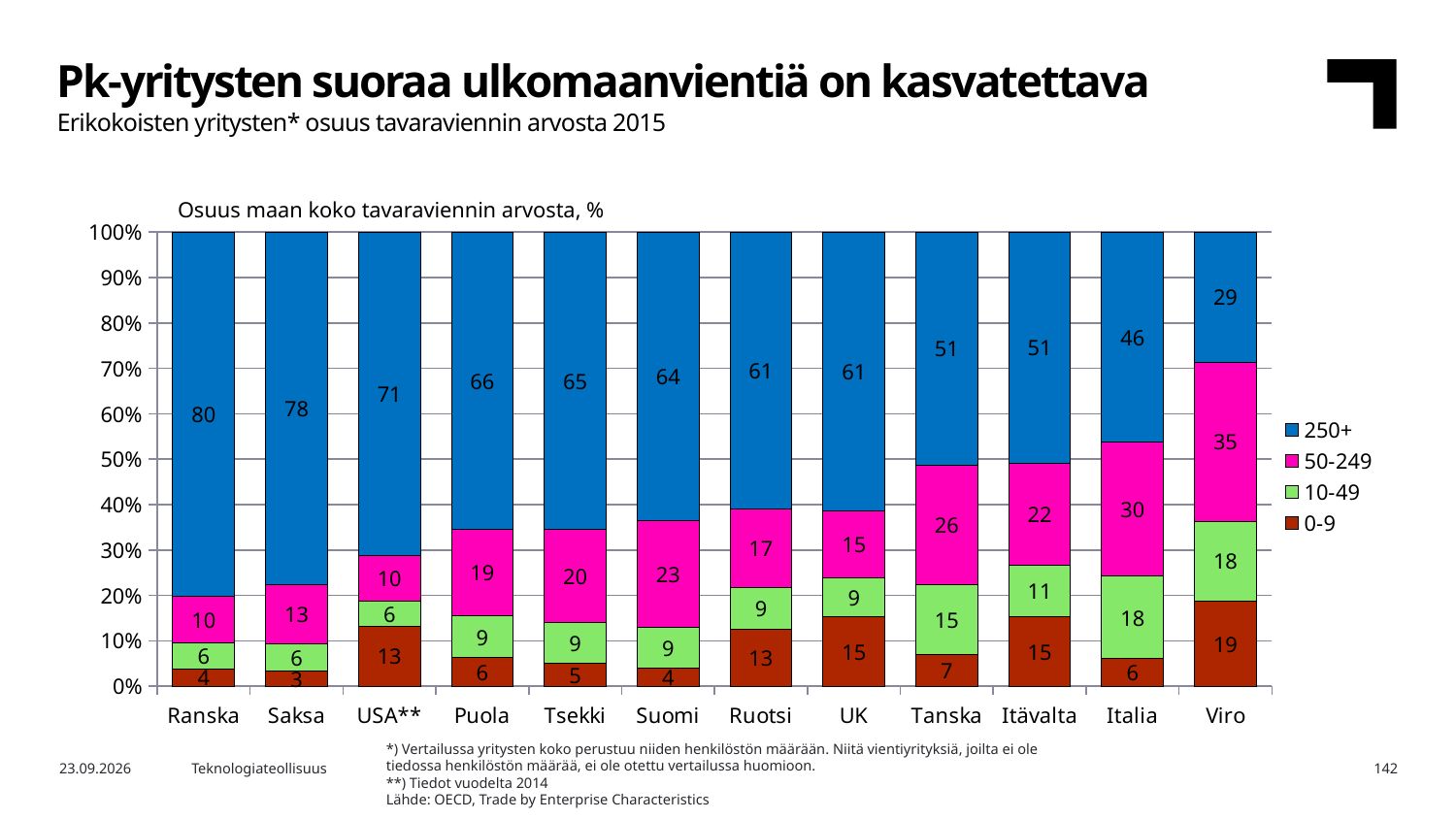
What is the difference between the 250+ values for Saksa and Italia? 32 How many countries are shown on the x axis? 12 What is the value of the 10-49 series for Italia? 18 What is the value of the 50-249 series for Suomi? 23 Which country has the highest value in the 250+ series? Ranska What is the value of the 0-9 series for Viro? 19 Which is larger: the 0-9 value for USA** or the 0-9 value for Puola? USA** What kind of chart is shown on the slide? Stacked bar chart Which country has the highest value in the 50-249 series? Viro How many series does the legend list? 4 Which country has the lowest value in the 250+ series? Viro What is the value of the 250+ series for Ranska? 80